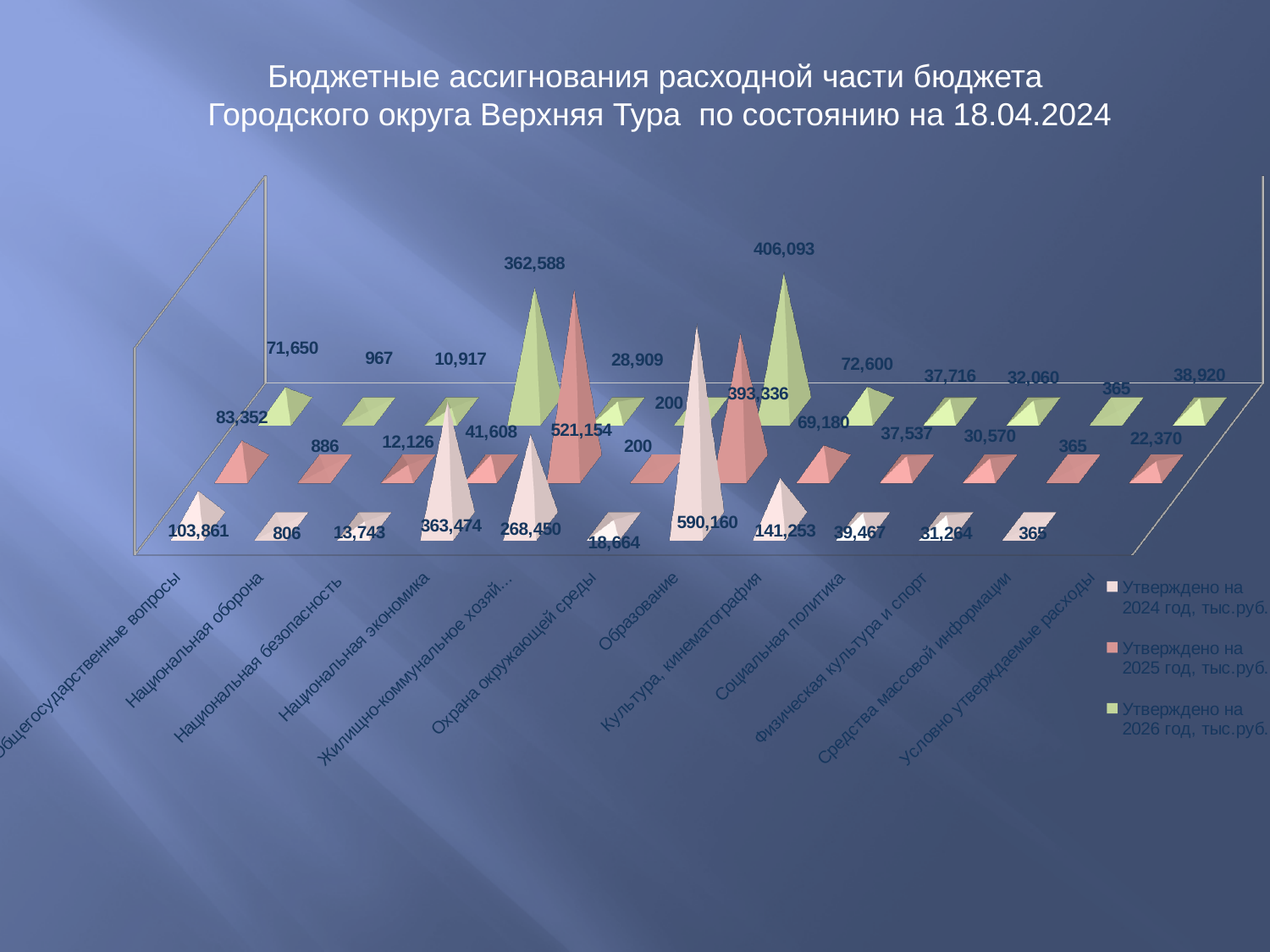
Which category has the highest value in the series 'Утверждено на 2024 год, тыс.руб.'? Образование What is the value for Социальная политика in the series 'Утверждено на 2025 год, тыс.руб.'? 37,537 For Жилищно-коммунальное хозяйство, which is larger: the 2024 value or the 2025 value? 2025 value What is the value for Образование in the series 'Утверждено на 2024 год, тыс.руб.'? 590,160 How many series does the legend list? 3 How many expenditure categories are shown along the x axis? 12 What is the value for Условно утверждаемые расходы in the series 'Утверждено на 2026 год, тыс.руб.'? 38,920 What is the difference between the 2024 and 2025 values for Образование? 196,824 What kind of chart is shown on the slide? bar chart What colour represents the series 'Утверждено на 2026 год, тыс.руб.'? green What is the value for Культура, кинематография in the series 'Утверждено на 2026 год, тыс.руб.'? 72,600 Which category has the lowest value in the series 'Утверждено на 2024 год, тыс.руб.'? Средства массовой информации